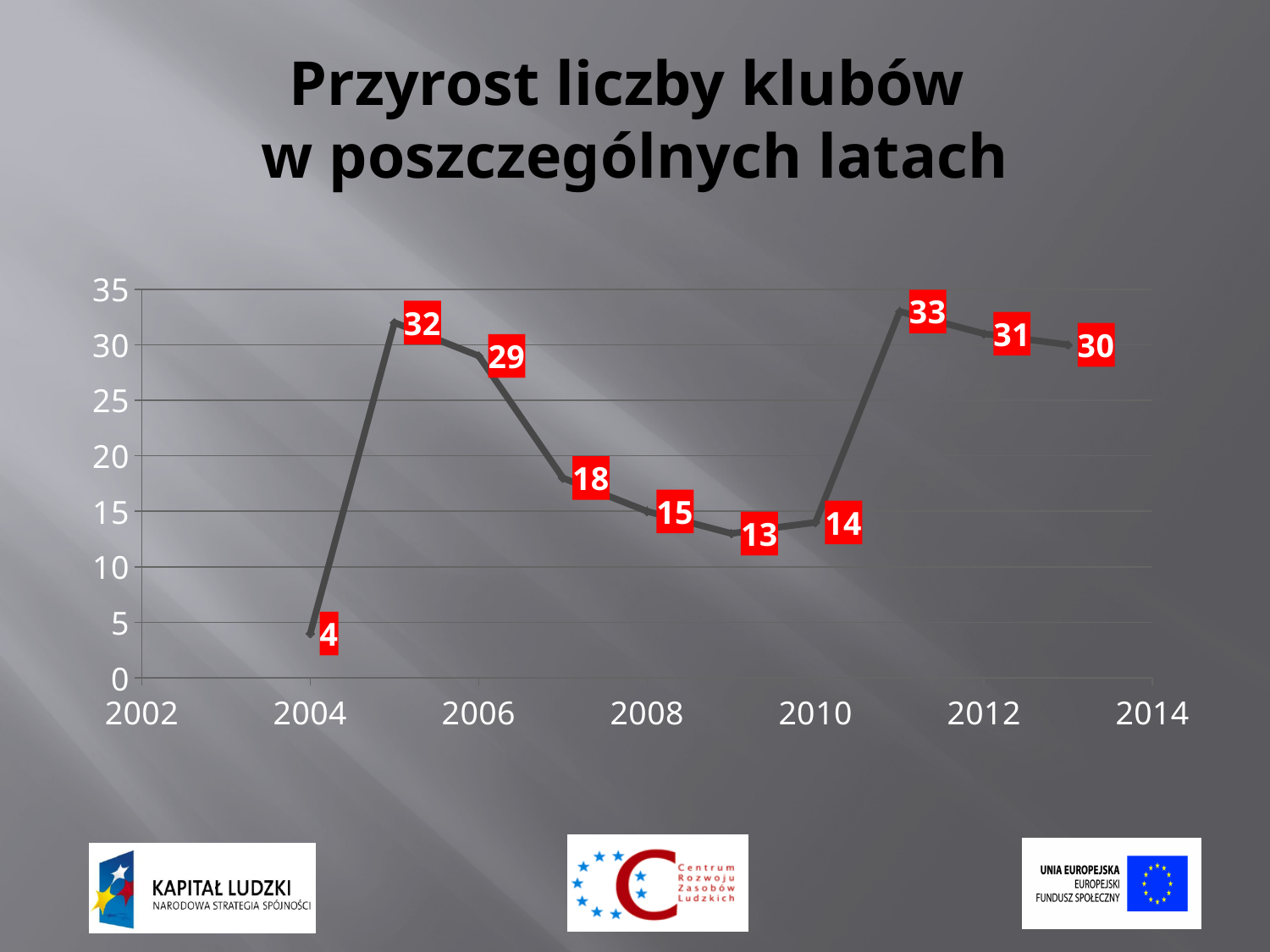
What is the value for 2004? 4 What is the value for 2010? 14 What kind of chart is shown on the slide? line chart Which is larger, the value for 2006 or the value for 2012? 2012 What is the difference between the values for 2006 and 2004? 25 How many data points are plotted on the line? 10 What is the highest value plotted on the chart? 33 What is the value for 2008? 15 What is the value for 2006? 29 Which year has the lowest value? 2004 What is the title of the chart? Przyrost liczby klubów w poszczególnych latach What is the value for 2012? 31